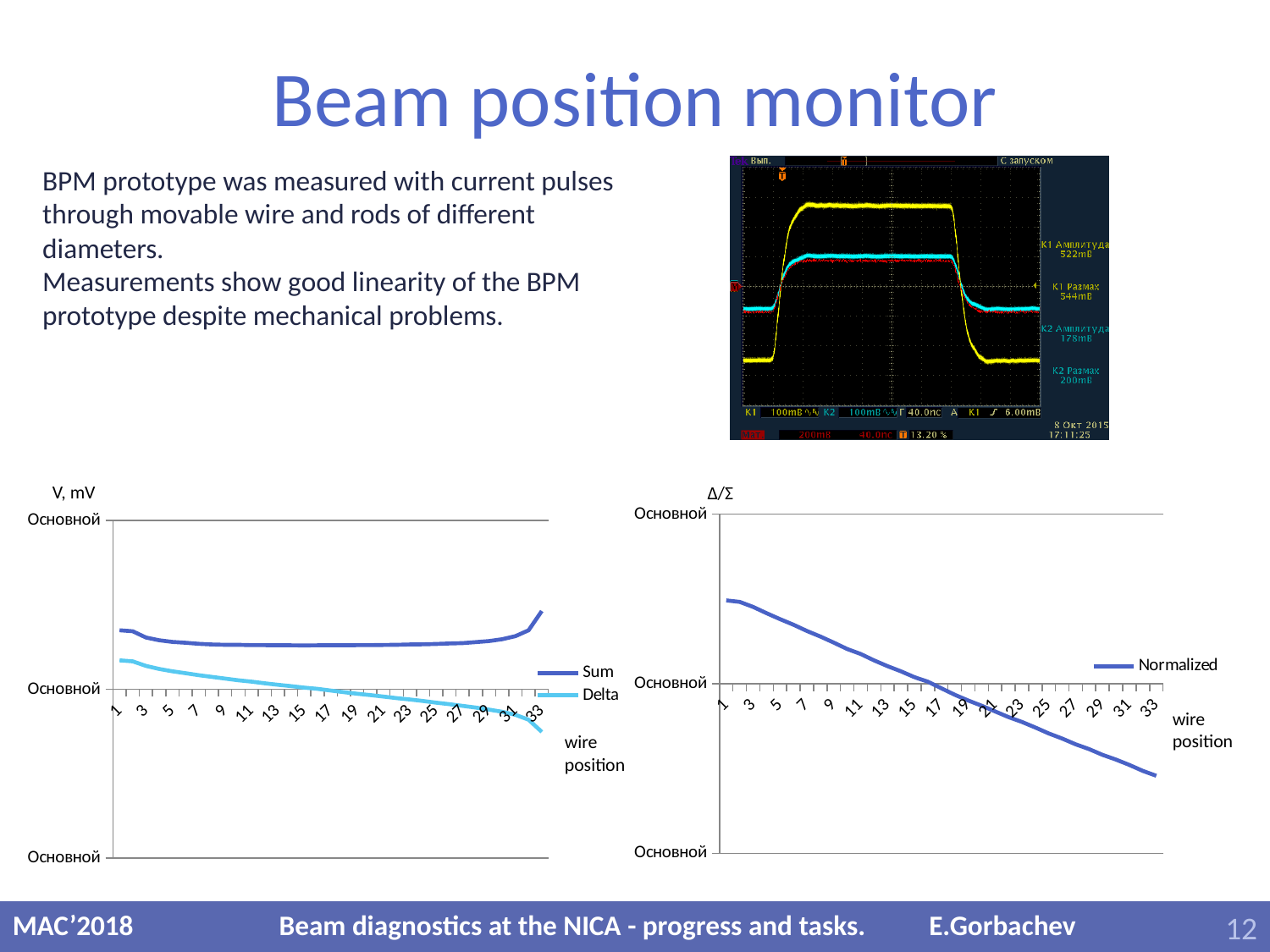
What kind of chart is the right chart with the y-axis labelled "Δ/Σ"? line chart What is the highest wire position label shown on the x axis of the right chart (Δ/Σ)? 33 What kind of chart is the left chart with the y-axis labelled "V, mV"? line chart What are the names of the series in the legend of the left chart (V, mV)? Sum and Delta In the left chart (V, mV), which series has the larger value at wire position 33, Sum or Delta? Sum In the left chart (V, mV), does the Delta series rise or fall as wire position increases? fall What is the label of the x axis on the left chart (V, mV)? wire position In the right chart (Δ/Σ), does the Normalized series rise or fall as wire position increases? fall What is the name of the series shown in the right chart (Δ/Σ)? Normalized How many series does the legend of the right chart (Δ/Σ) list? 1 In the left chart (V, mV), which series has the larger value at wire position 1, Sum or Delta? Sum How many series does the legend of the left chart (V, mV) list? 2